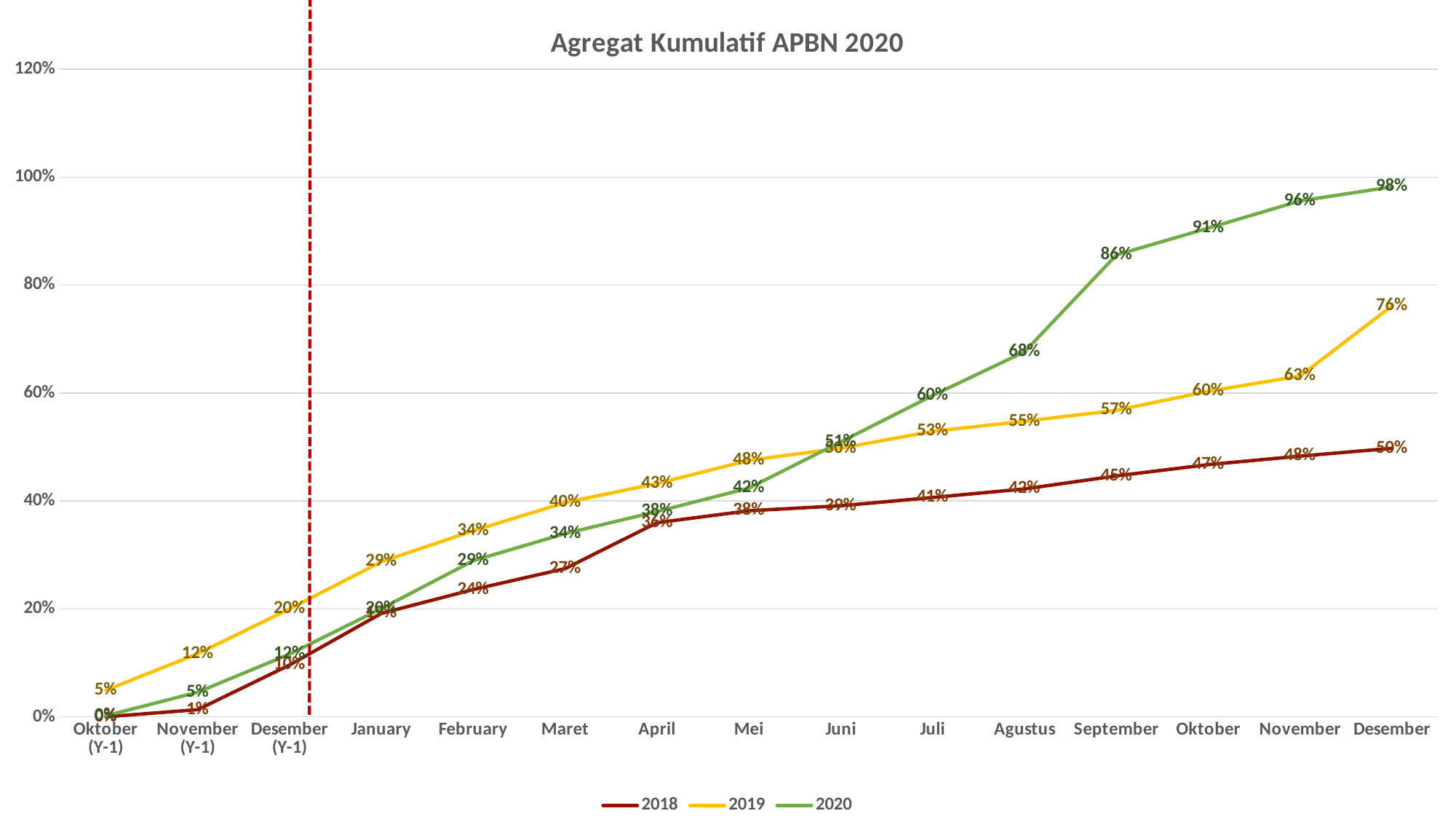
Which series has the highest value in Desember? 2020 What kind of chart is shown on the slide? line chart What is the value for 2018 in April? 36% What is the title of the chart? Agregat Kumulatif APBN 2020 What is the difference between the 2020 and 2019 values in Desember? 22 percentage points What is the value for 2020 in Desember? 98% In Agustus, which series has the larger value, 2019 or 2020? 2020 Do the values for the 2020 series rise or fall along the x axis? rise How many categories are on the x axis? 15 What is the value for 2019 in Desember? 76% How many series does the legend list? 3 What is the value for 2020 in September? 86%